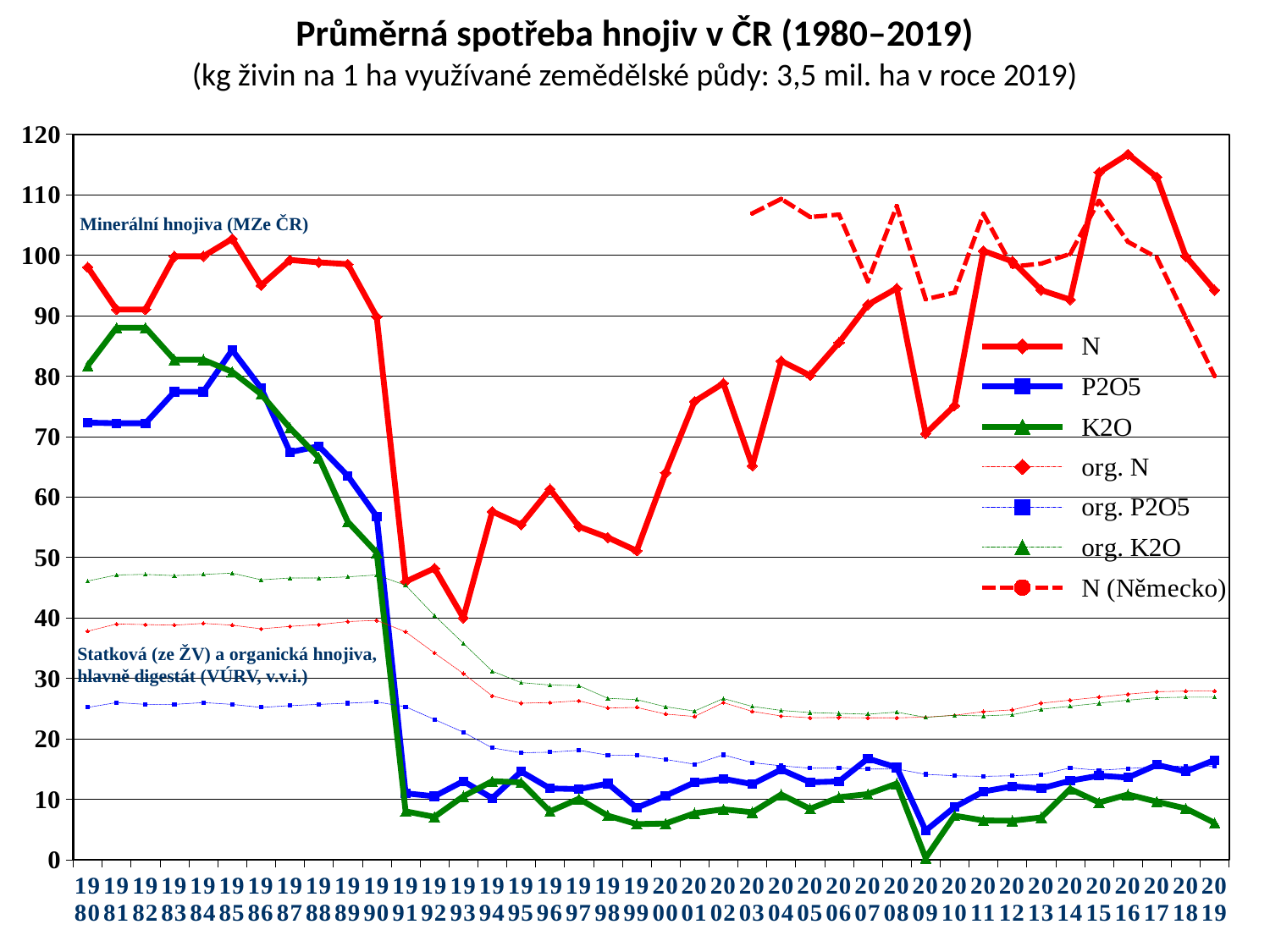
How many years are plotted along the x axis? 40 How many series does the legend list? 7 In 1982, which is larger, K2O or P2O5? K2O Is the value for K2O in 1991 greater or less than 10? less Which series is drawn with a dashed line? N (Německo) Is the value for N in 1993 greater or less than 50? less What kind of chart is shown on the slide? line chart Is the value for N in 1980 greater or less than 90? greater In which year does the N series reach its lowest value? 1993 In which year does the N series reach its highest value? 2016 Do the K2O values rise or fall from 1985 to 1991? fall